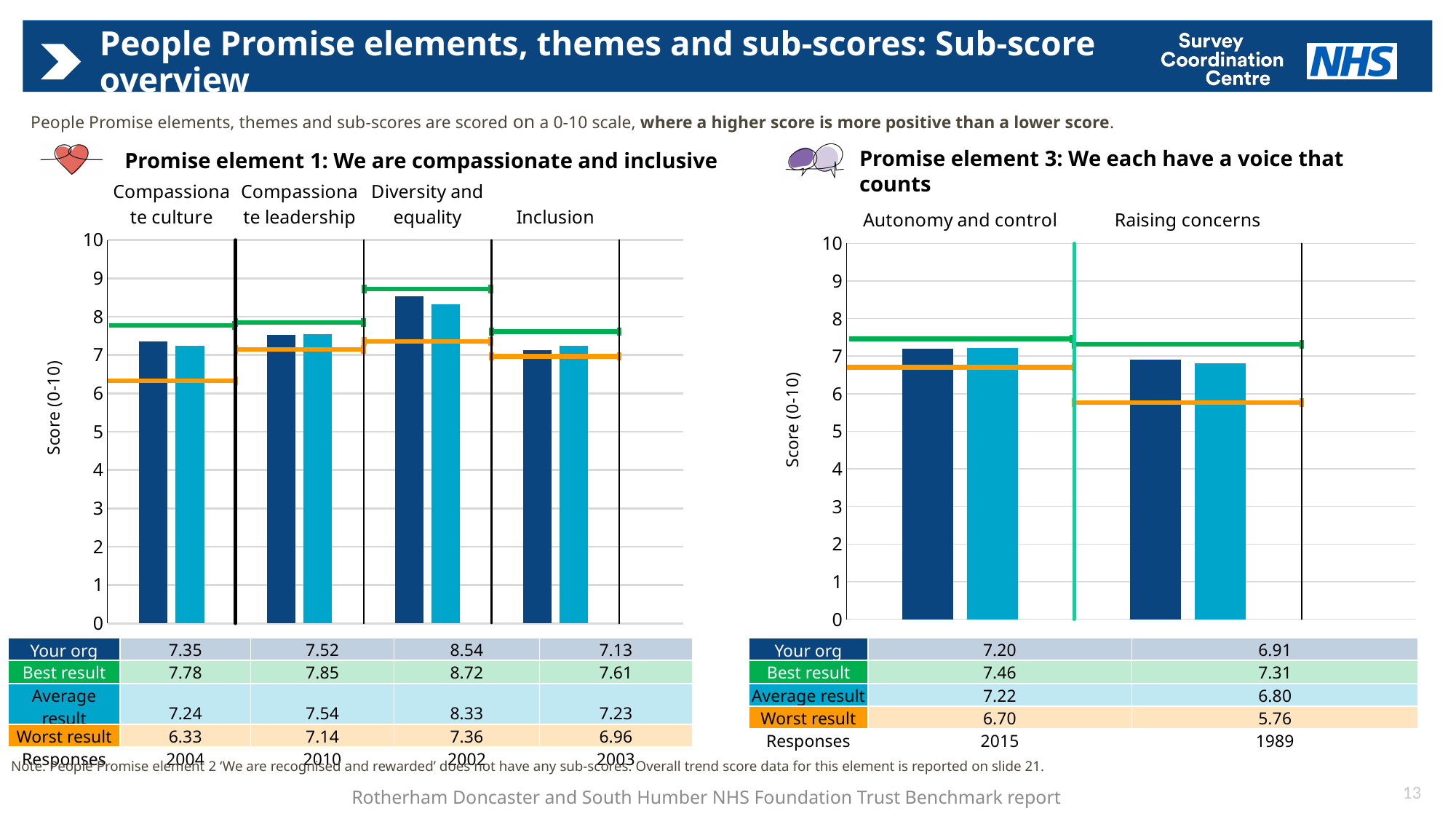
In the 'Promise element 1: We are compassionate and inclusive' chart, what is the 'Your org' score for Diversity and equality? 8.54 In the 'Promise element 1: We are compassionate and inclusive' chart, what is the Average result for Compassionate leadership? 7.54 In the 'Promise element 3: We each have a voice that counts' chart, what is the difference between the 'Your org' score and the Best result for Autonomy and control? 0.26 In the 'Promise element 1: We are compassionate and inclusive' chart, which sub-score has the lowest 'Your org' value? Inclusion In the 'Promise element 3: We each have a voice that counts' chart, how many responses are recorded for Autonomy and control? 2015 In the 'Promise element 1: We are compassionate and inclusive' chart, what is the difference between the Best result and the Worst result for Compassionate culture? 1.45 In the 'Promise element 1: We are compassionate and inclusive' chart, is the 'Your org' score for Compassionate culture higher or lower than the Average result? higher How many sub-scores are shown in the 'Promise element 1: We are compassionate and inclusive' chart? 4 What type of chart is used for 'Promise element 3: We each have a voice that counts'? bar chart In the 'Promise element 3: We each have a voice that counts' chart, what is the 'Your org' score for Raising concerns? 6.91 In the 'Promise element 1: We are compassionate and inclusive' chart, which sub-score has the highest 'Your org' value? Diversity and equality In the 'Promise element 3: We each have a voice that counts' chart, what is the Worst result for Raising concerns? 5.76